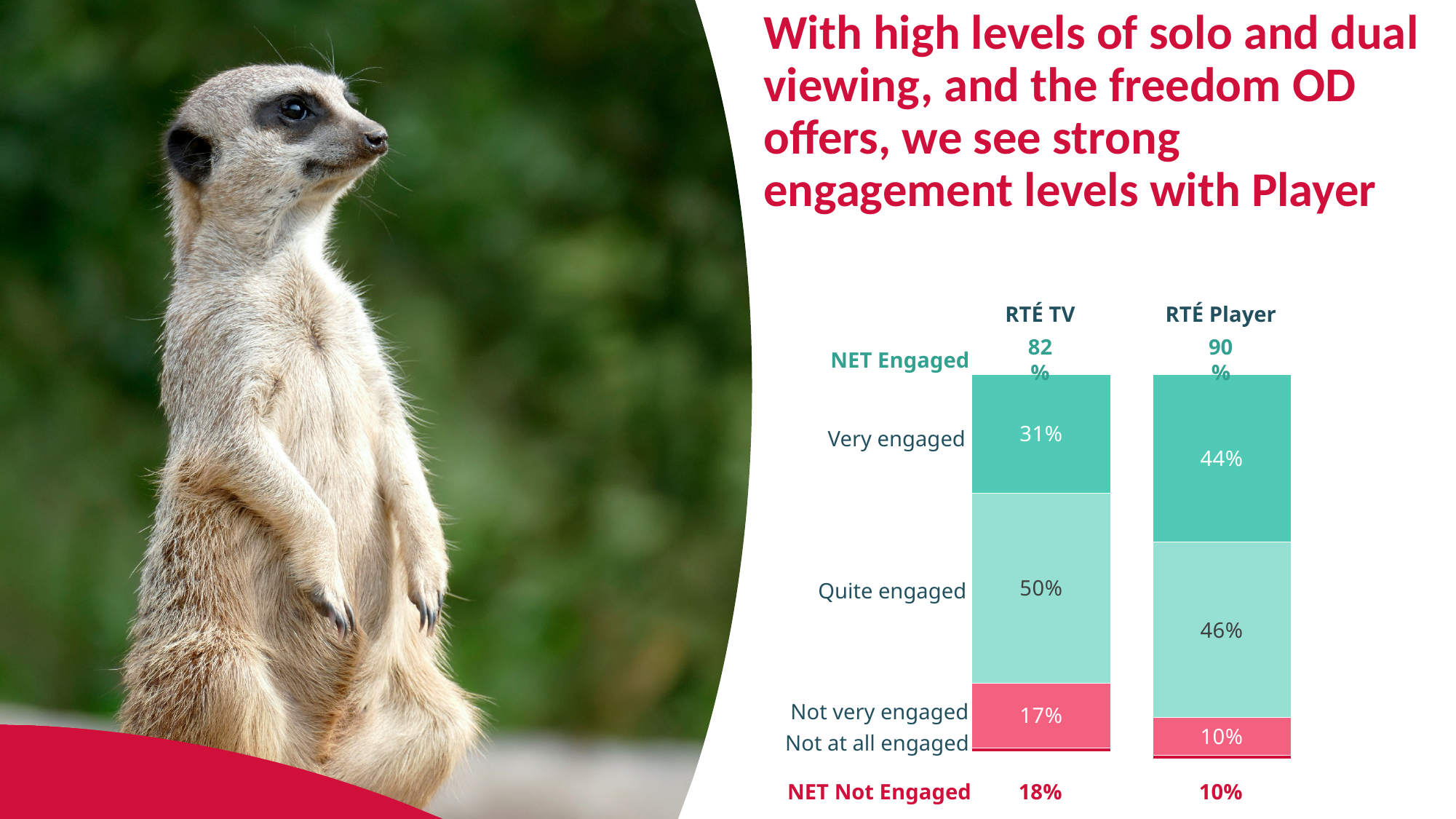
What is the NET Not Engaged figure for RTÉ TV? 18% What is the NET Engaged figure for RTÉ Player? 90% What is the difference between the 'Very engaged' values for RTÉ Player and RTÉ TV? 13% Which has the higher 'Very engaged' share, RTÉ TV or RTÉ Player? RTÉ Player How many bars (columns) are shown in the chart? 2 What percentage of RTÉ TV viewers are 'Very engaged'? 31% What percentage of RTÉ Player viewers are 'Very engaged'? 44% What is the difference between the NET Engaged figures for RTÉ Player and RTÉ TV? 8% What is the 'Not very engaged' value for RTÉ Player? 10% What is the 'Quite engaged' value for RTÉ TV? 50% What type of chart is shown on the slide? Stacked bar chart Which has the higher 'Quite engaged' share, RTÉ TV or RTÉ Player? RTÉ TV